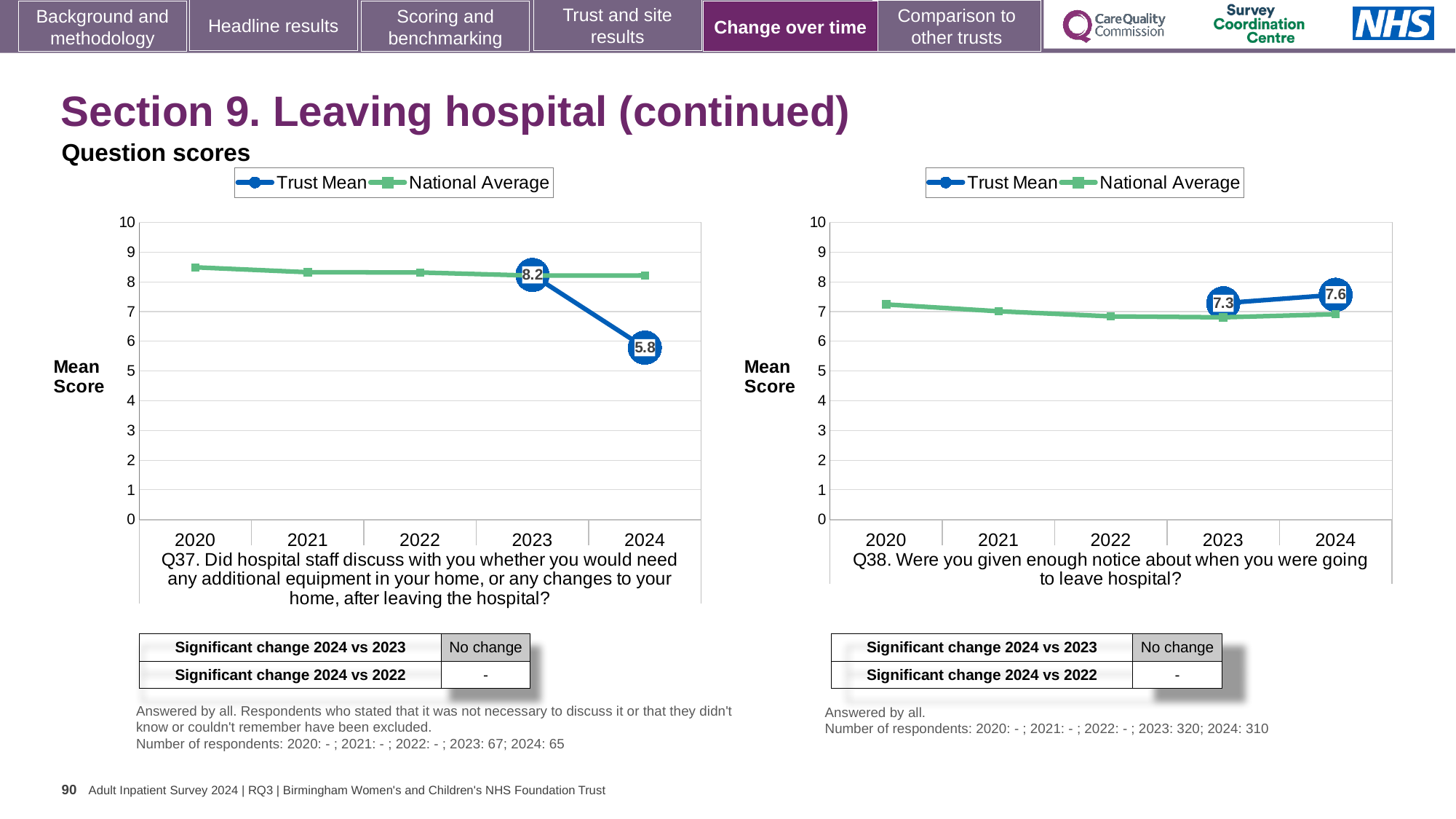
In the Q38 chart (right), does the Trust Mean rise or fall from 2023 to 2024? rise In the Q37 chart (left), is the National Average for 2020 greater or less than 8? greater In the Q38 chart (right), what is the difference between the Trust Mean in 2024 and 2023? 0.3 In the Q37 chart (left), what is the Trust Mean score for 2024? 5.8 How many series does the legend of the Q38 chart (right) list? 2 In the Q38 chart (right), which is higher in 2024: the Trust Mean or the National Average? Trust Mean In the Q37 chart (left), what is the Trust Mean score for 2023? 8.2 In the Q37 chart (left), which is higher in 2024: the Trust Mean or the National Average? National Average In the Q37 chart (left), by how much did the Trust Mean fall from 2023 to 2024? 2.4 In the Q38 chart (right), what is the Trust Mean score for 2024? 7.6 What type of chart is used for Q37 (left)? Line chart In the Q38 chart (right), what is the Trust Mean score for 2023? 7.3